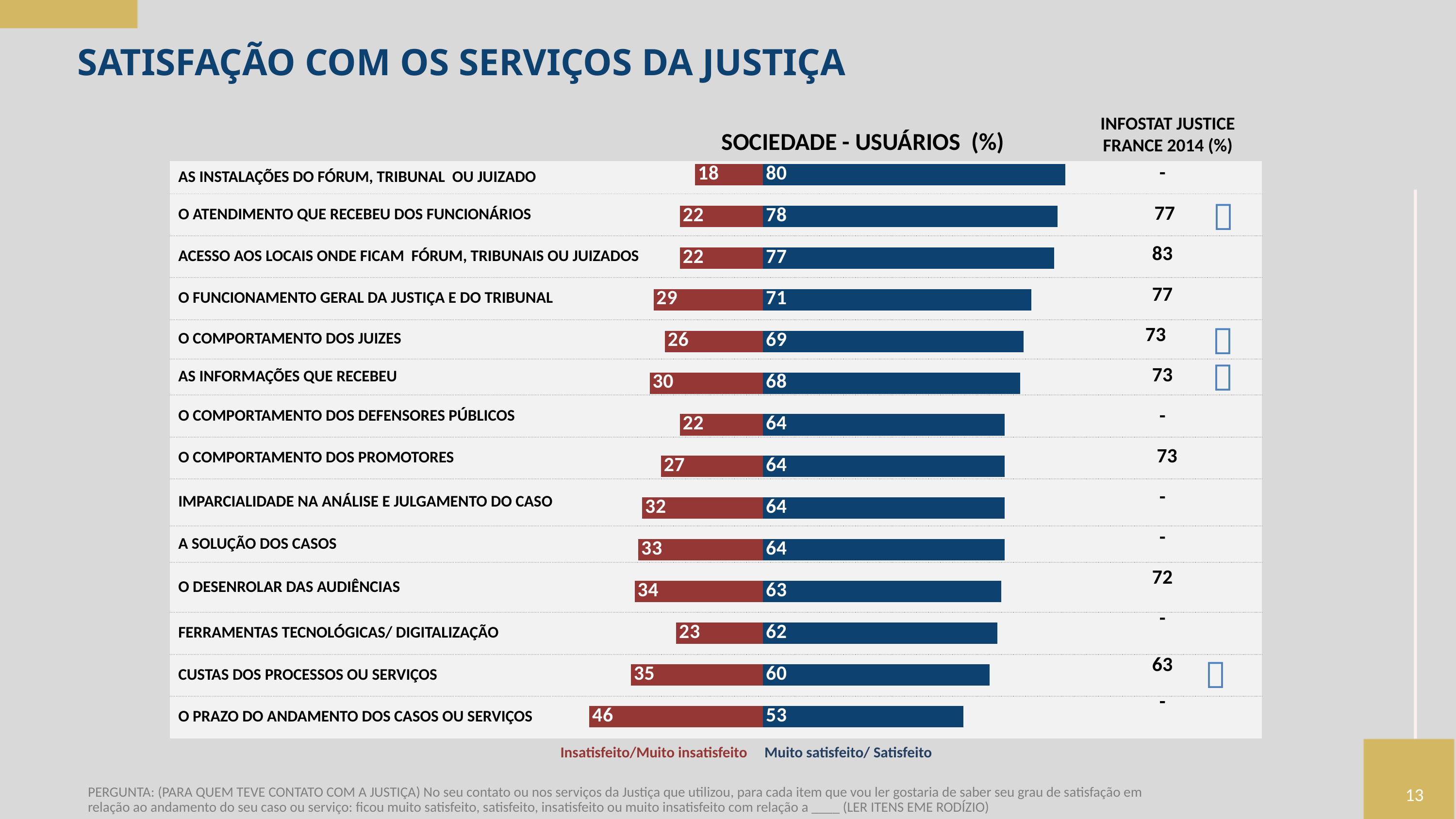
How many series does the legend list? 2 Which item has the highest dissatisfied (Insatisfeito/Muito insatisfeito) percentage? O PRAZO DO ANDAMENTO DOS CASOS OU SERVIÇOS Which item has the lowest satisfied (Muito satisfeito/ Satisfeito) percentage? O PRAZO DO ANDAMENTO DOS CASOS OU SERVIÇOS What percentage of users are dissatisfied (Insatisfeito/Muito insatisfeito) with O PRAZO DO ANDAMENTO DOS CASOS OU SERVIÇOS? 46 Which colour represents Insatisfeito/Muito insatisfeito in the chart? Red How many items (categories) are shown in the chart? 14 Which has a higher dissatisfied (Insatisfeito/Muito insatisfeito) percentage: O COMPORTAMENTO DOS JUIZES or AS INFORMAÇÕES QUE RECEBEU? AS INFORMAÇÕES QUE RECEBEU Which item has the highest satisfied (Muito satisfeito/ Satisfeito) percentage? AS INSTALAÇÕES DO FÓRUM, TRIBUNAL OU JUIZADO What kind of chart is shown on the slide? Bar chart What is the satisfied (Muito satisfeito/ Satisfeito) value for CUSTAS DOS PROCESSOS OU SERVIÇOS? 60 What percentage of users are satisfied (Muito satisfeito/ Satisfeito) with AS INSTALAÇÕES DO FÓRUM, TRIBUNAL OU JUIZADO? 80 What is the difference between the satisfied and dissatisfied percentages for O FUNCIONAMENTO GERAL DA JUSTIÇA E DO TRIBUNAL? 42